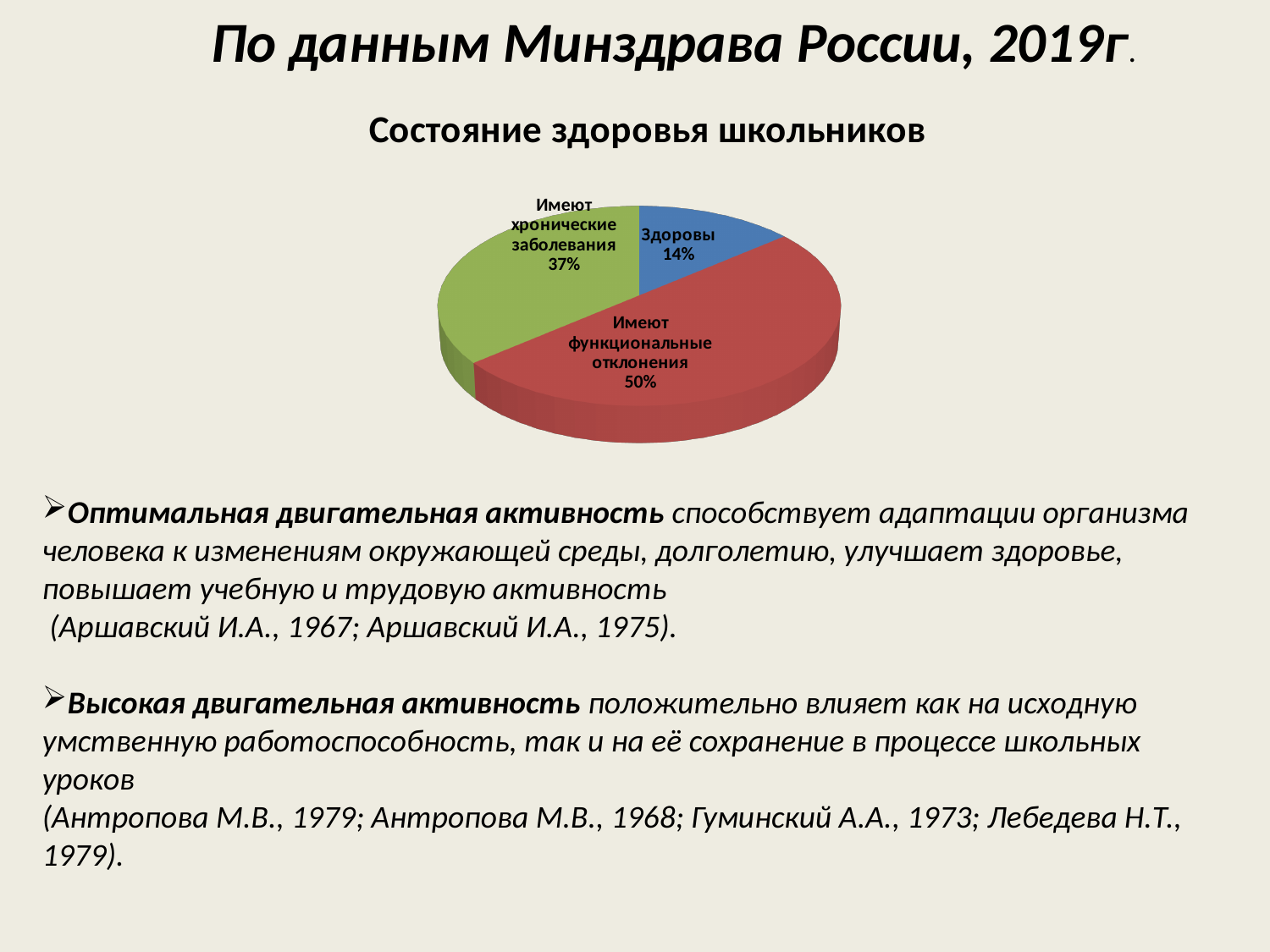
What share of schoolchildren are labelled 'Здоровы'? 14% Which category has the largest share of the pie? Имеют функциональные отклонения What colour is the slice for 'Здоровы'? Blue What is the difference between the share for 'Имеют хронические заболевания' and the share for 'Здоровы'? 23% What is the chart's title? Состояние здоровья школьников How many categories does the pie chart show? 3 What share of schoolchildren 'Имеют функциональные отклонения'? 50% Which is larger: the share for 'Имеют хронические заболевания' or the share for 'Здоровы'? Имеют хронические заболевания What kind of chart is shown on the slide? Pie chart What is the difference between the share for 'Имеют функциональные отклонения' and the share for 'Здоровы'? 36% What share of schoolchildren 'Имеют хронические заболевания'? 37% Which category has the smallest share of the pie? Здоровы